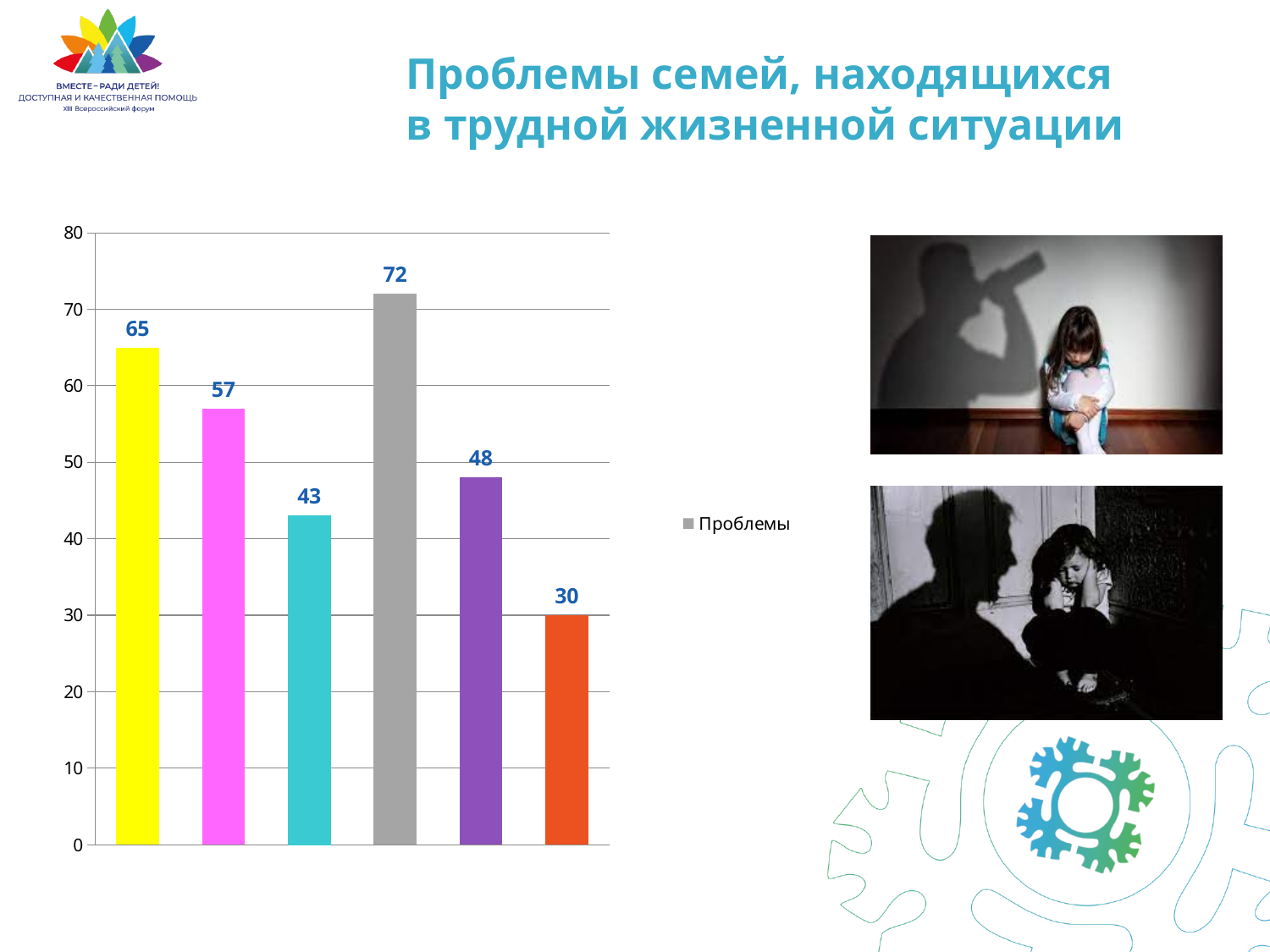
Which bar has the highest value in the chart? the fourth (gray) bar, 72 What type of chart is shown on the slide? bar chart Which is larger: the second (pink) bar or the fifth (purple) bar? the second (pink) bar, 57 What is the value of the last (orange) bar in the chart? 30 What is the value of the first (yellow) bar in the chart? 65 What is the value of the third (cyan) bar in the chart? 43 What is the difference between the highest bar (72) and the lowest bar (30)? 42 How many bars are plotted in the chart? 6 What is the value of the fourth (gray) bar in the chart? 72 What is the name of the series shown in the chart legend? Проблемы Which bar has the lowest value in the chart? the last (orange) bar, 30 How many series does the chart legend list? 1